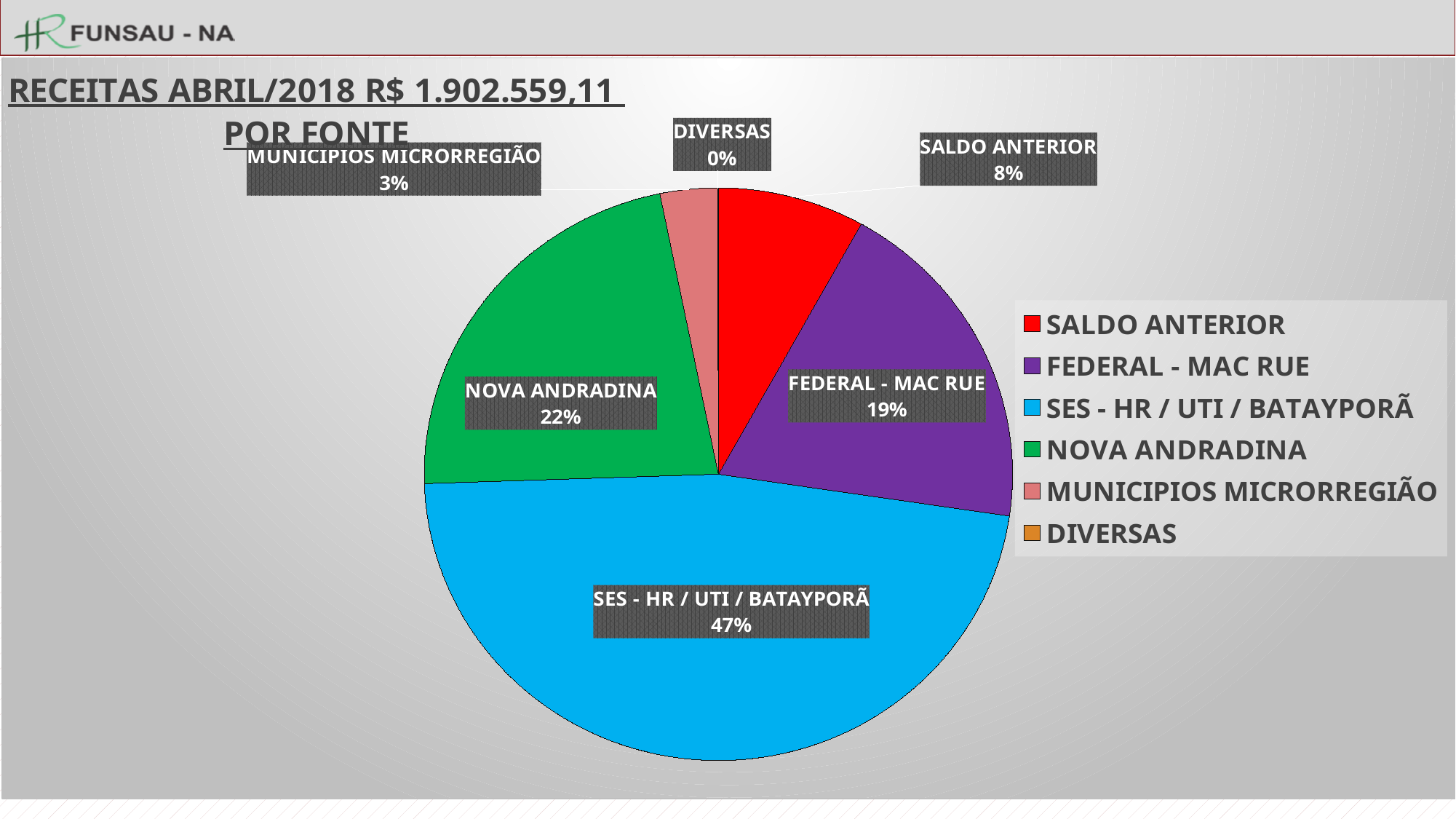
What percentage is shown for NOVA ANDRADINA? 22% How many categories does the legend list? 6 Which category has the smallest share of the pie? DIVERSAS What kind of chart is shown on the slide? Pie chart What percentage is shown for FEDERAL - MAC RUE? 19% Which is larger, the share for SALDO ANTERIOR or the share for MUNICIPIOS MICRORREGIÃO? SALDO ANTERIOR What colour is the SES - HR / UTI / BATAYPORÃ slice? Blue Which category has the largest share of the pie? SES - HR / UTI / BATAYPORÃ What percentage is shown for SALDO ANTERIOR? 8% What percentage is shown for MUNICIPIOS MICRORREGIÃO? 3% What is the difference in percentage points between NOVA ANDRADINA and FEDERAL - MAC RUE? 3 What share of the pie does SES - HR / UTI / BATAYPORÃ represent? 47%